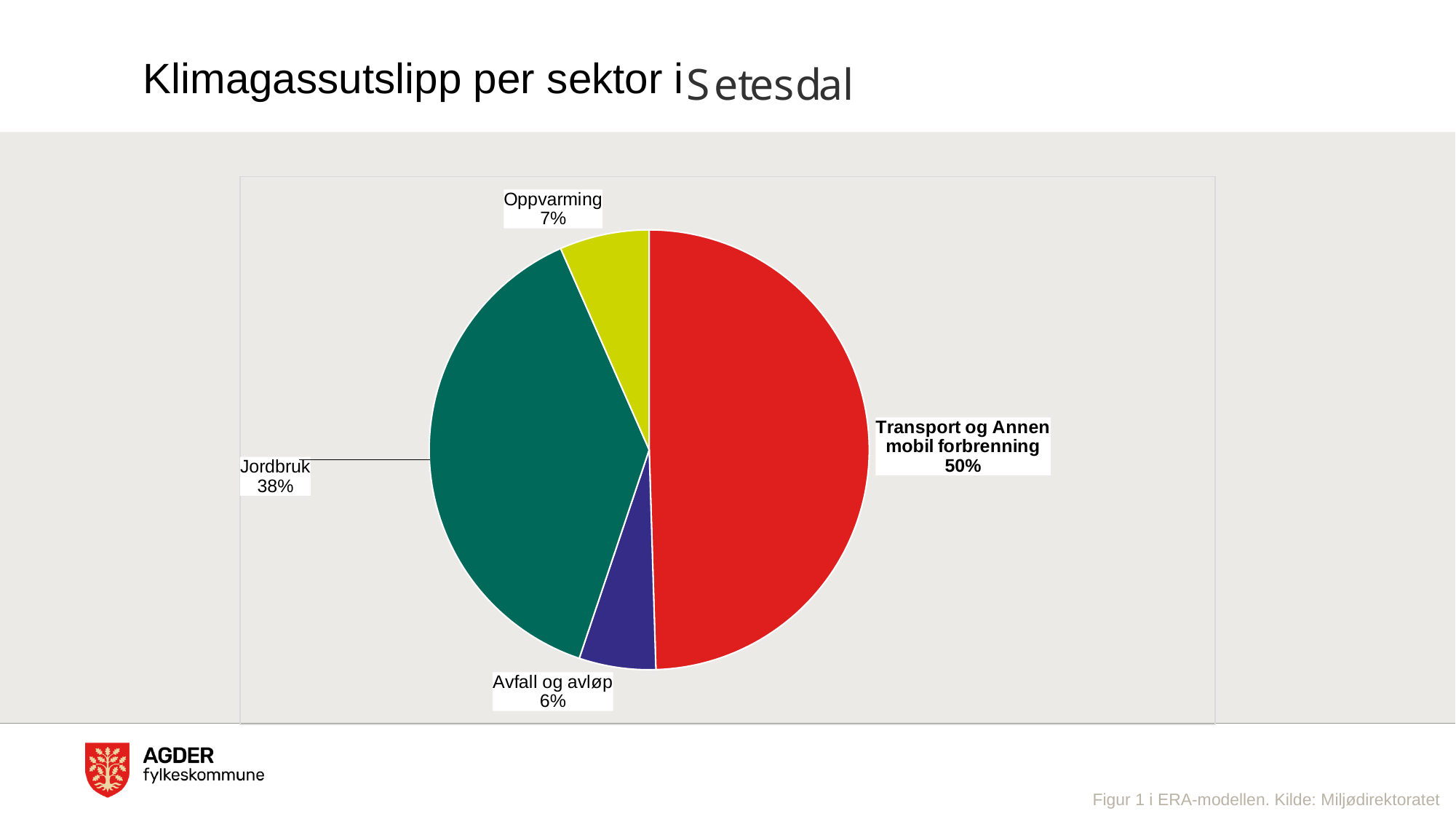
What share of emissions does Transport og Annen mobil forbrenning account for? 50% What share of emissions does Avfall og avløp account for? 6% What type of chart is shown on the slide? pie chart What colour is the Jordbruk slice? dark green Which is larger, the share for Jordbruk or the share for Oppvarming? Jordbruk What is the difference in percentage points between Transport og Annen mobil forbrenning and Jordbruk? 12 percentage points Which sector has the smallest share of emissions? Avfall og avløp What is the title of the slide? Klimagassutslipp per sektor i Setesdal What share of emissions does Oppvarming account for? 7% What share of emissions does Jordbruk account for? 38% Which sector has the largest share of emissions? Transport og Annen mobil forbrenning How many sectors are shown in the pie chart? 4